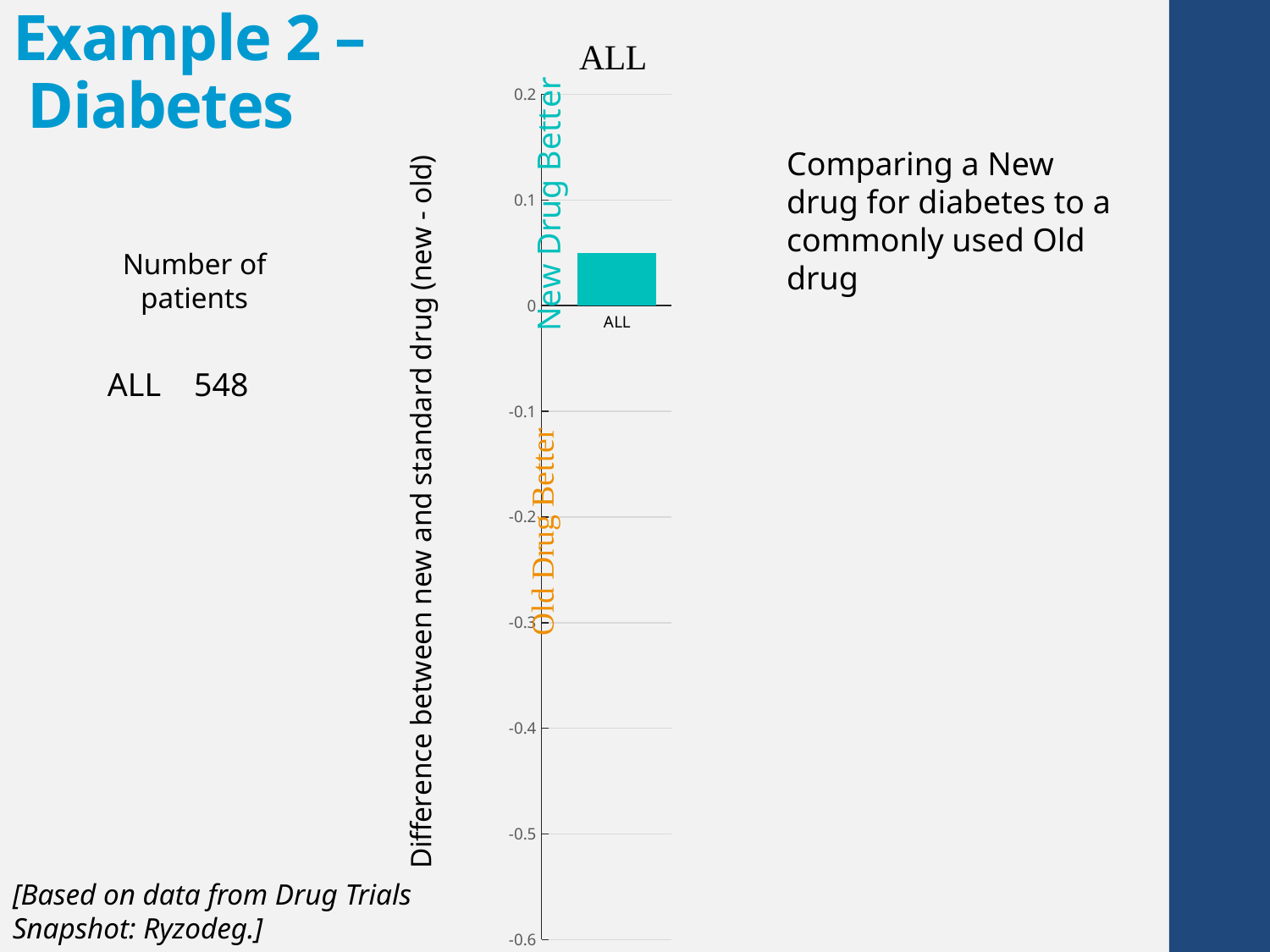
How many bars are plotted in the chart? 1 Does the bar for ALL fall on the 'New Drug Better' side or the 'Old Drug Better' side of the axis? New Drug Better What is the highest tick value shown on the vertical axis? 0.2 Is the value for ALL greater or less than 0? greater Is the value for ALL greater or less than 0.1? less What kind of chart is shown on the slide? bar chart Is the value for ALL greater or less than -0.1? greater What is the lowest tick value shown on the vertical axis? -0.6